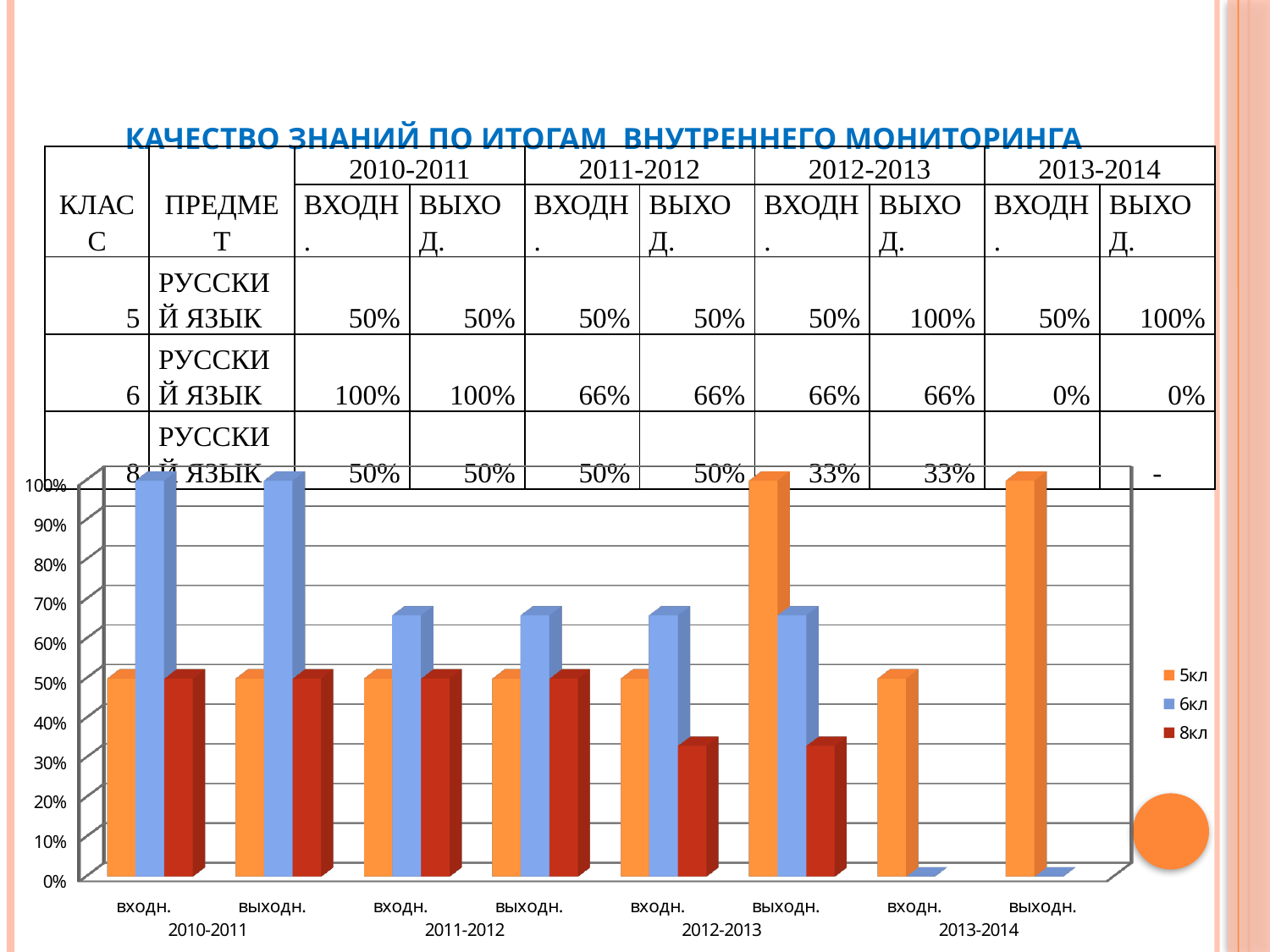
What is the value for 5кл at выходн. 2012-2013 in the chart? 100% What is the value for 8кл at входн. 2010-2011 in the chart? 50% What is the value for 6кл at входн. 2010-2011 in the chart? 100% What kind of chart is shown at the bottom of the slide? bar chart At входн. 2010-2011, which is larger: the value for 5кл or the value for 6кл? 6кл Which series has the highest value at выходн. 2012-2013? 5кл Is the value for 8кл at выходн. 2012-2013 greater or less than 40%? less Which colour represents the 8кл series in the chart legend? dark red What is the value for 6кл at входн. 2013-2014 in the chart? 0% How many categories (bar groups) are shown along the x axis of the chart? 8 Is the value for 6кл at входн. 2011-2012 greater or less than 60%? greater How many series does the chart legend list? 3